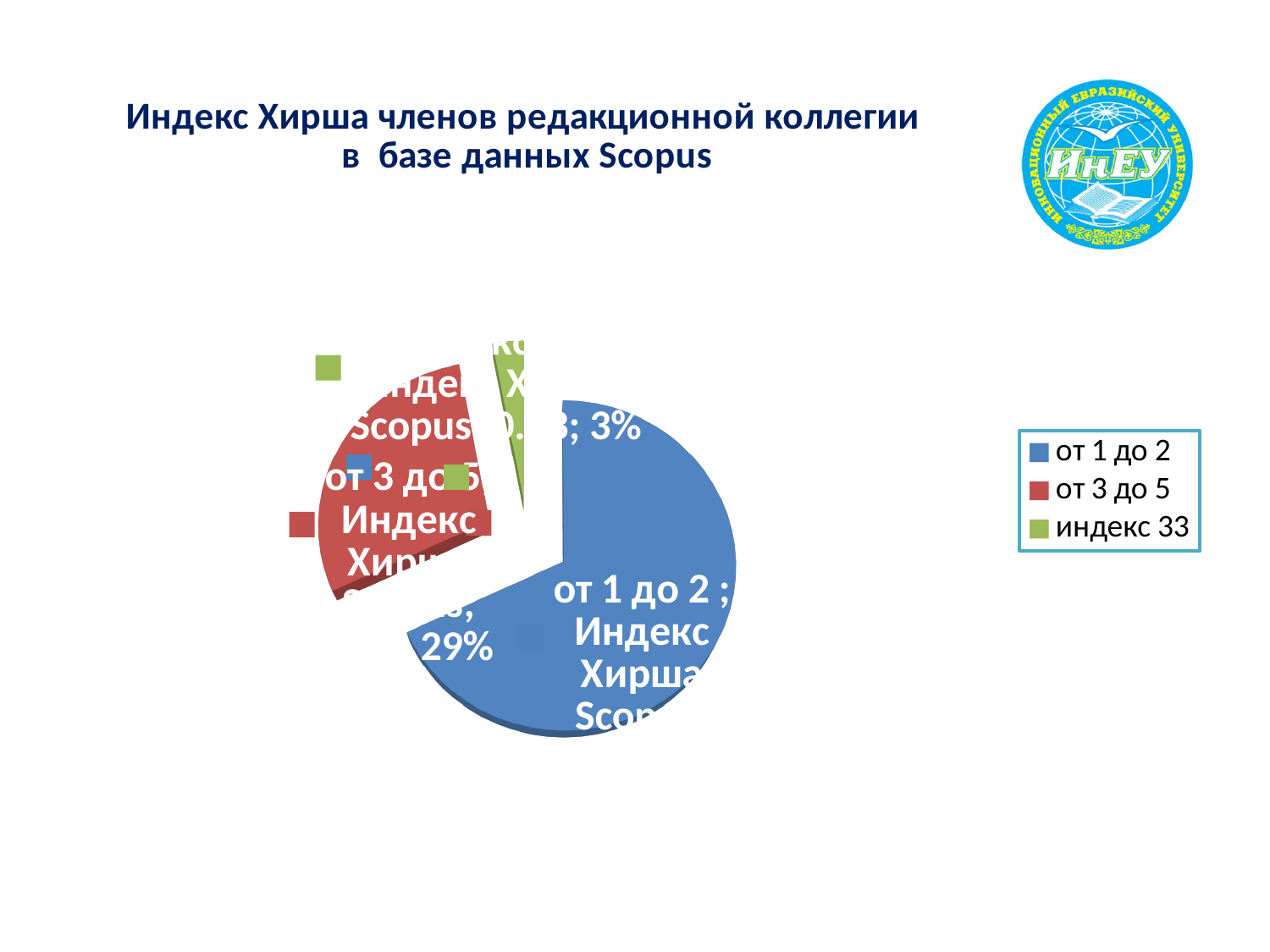
How many entries does the legend of the pie chart list? 3 What share of the pie does the category "от 3 до 5" have? 29% By how many percentage points does the share of "от 3 до 5" exceed the share of "индекс 33"? 26 What colour is the slice for "от 1 до 2" in the pie chart? Blue Which category has the smallest slice in the pie chart? индекс 33 How many slices does the pie chart have? 3 Which slice is larger: "от 3 до 5" or "индекс 33"? от 3 до 5 Which category has the largest slice in the pie chart? от 1 до 2 What is the title of the slide containing the pie chart? Индекс Хирша членов редакционной коллегии в базе данных Scopus What kind of chart is shown on the slide? Pie chart What share of the pie does the category "индекс 33" have? 3%